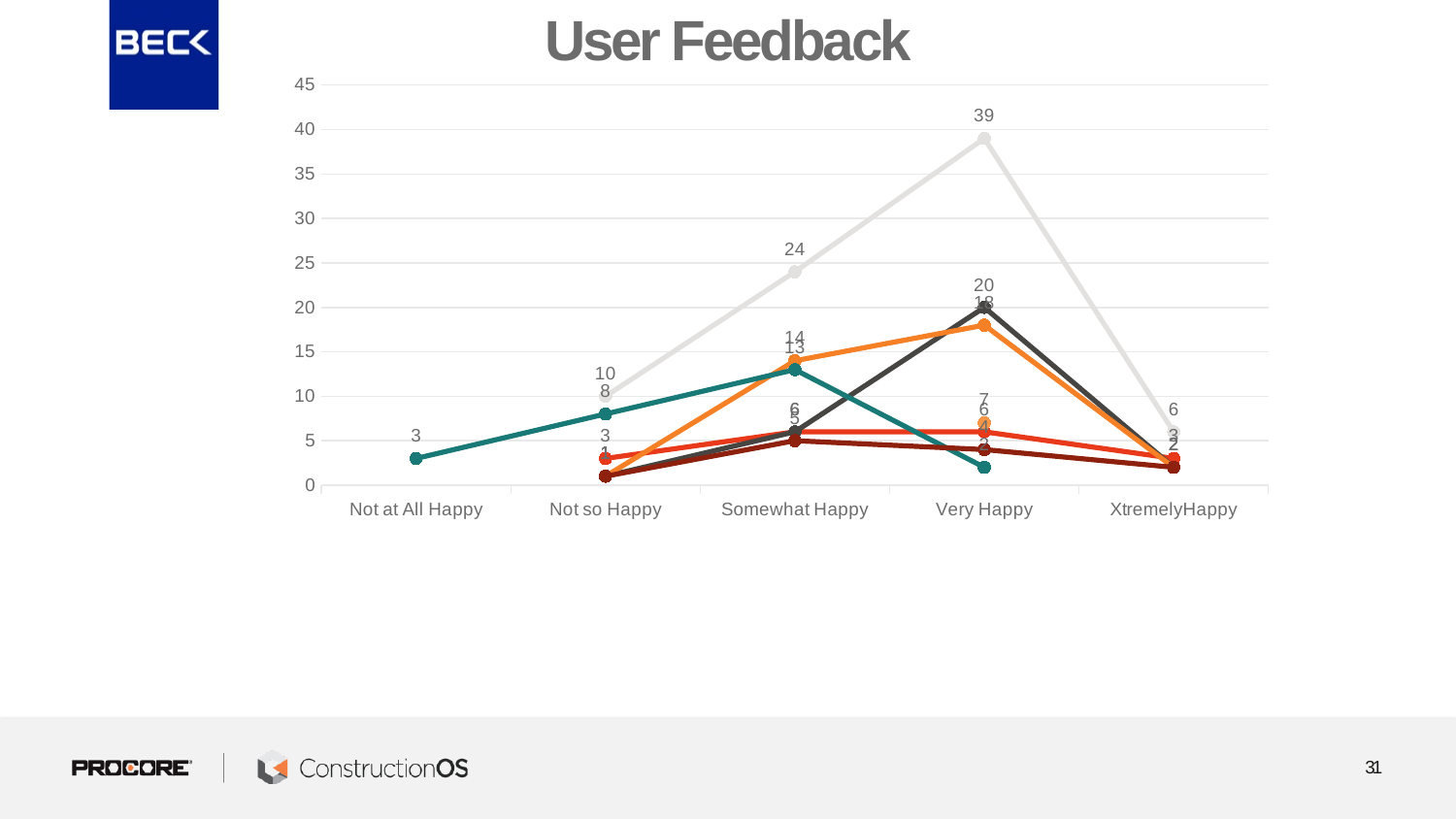
What kind of chart is shown on the slide? line chart What is the value of the light grey line at Somewhat Happy? 24 Does the light grey line rise or fall from Not so Happy to Very Happy? rise What is the value of the light grey line at Very Happy? 39 What is the difference between the light grey line's values at Very Happy and Somewhat Happy? 15 What is the value of the dark grey line at Very Happy? 20 How many categories are shown on the x axis? 5 What is the title of the chart? User Feedback Is the value of the light grey line at Very Happy greater or less than 35? greater What is the value of the orange line at Somewhat Happy? 14 At which category does the light grey line reach its highest value? Very Happy What is the value of the teal line at Not at All Happy? 3